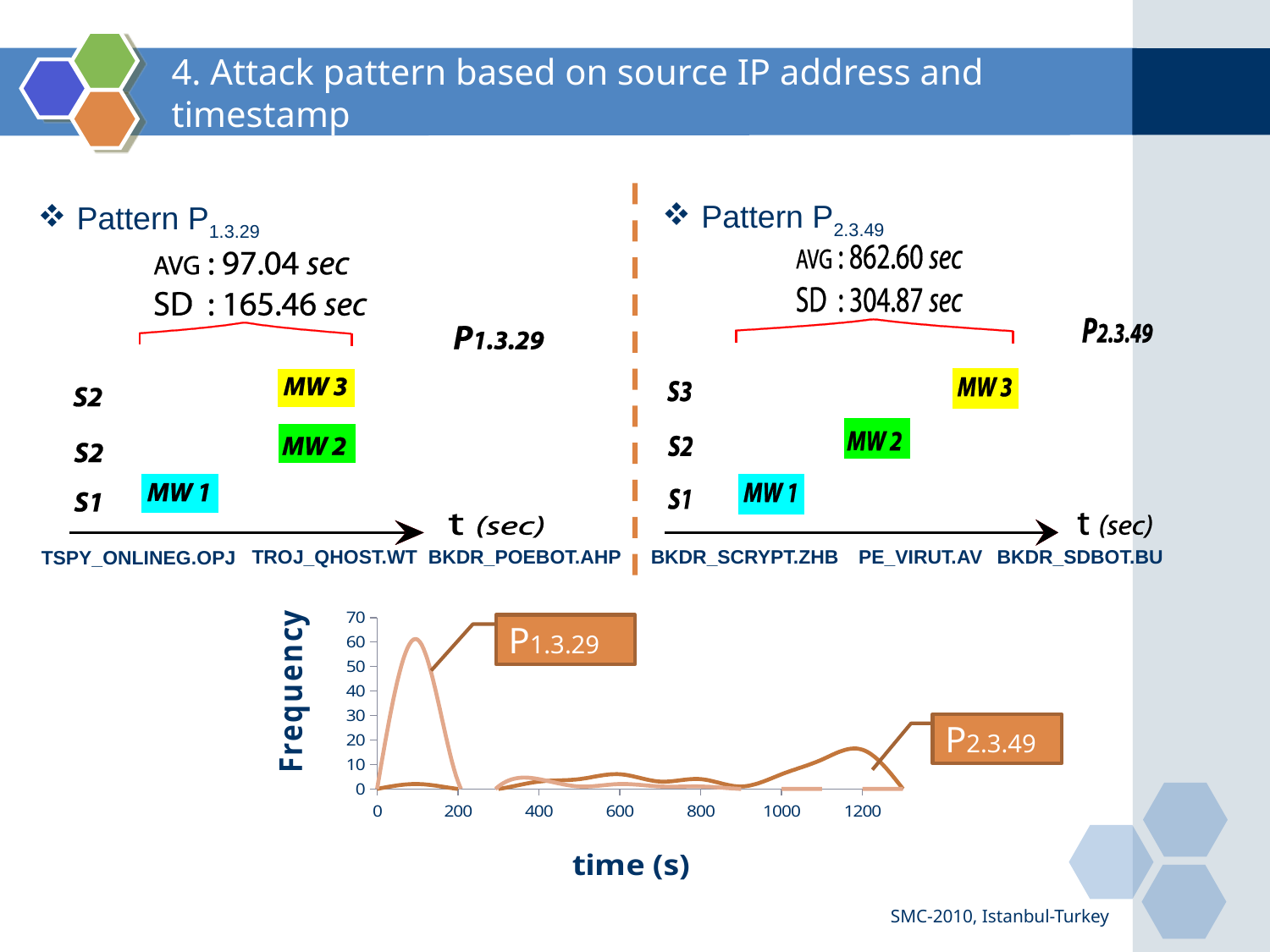
In the bottom chart, which pattern reaches the higher peak frequency, P1.3.29 or P2.3.49? P1.3.29 What is the label of the vertical axis of the bottom chart? Frequency What is the label of the horizontal axis of the bottom chart? time (s) What kind of chart is shown at the bottom of the slide? line chart In the bottom chart, is the peak frequency of P2.3.49 greater or less than 30? less In the bottom chart, is the peak frequency of P1.3.29 greater or less than 40? greater In the bottom chart, does the peak of P2.3.49 occur at a time greater or less than 1000 s? greater How many patterns are labelled in the bottom frequency chart? 2 In the Pattern P2.3.49 diagram, what is the SD value shown? 304.87 sec In the Pattern P1.3.29 diagram, what is the AVG value shown? 97.04 sec In the bottom chart, does the frequency of P2.3.49 rise or fall between 900 s and 1200 s? rise